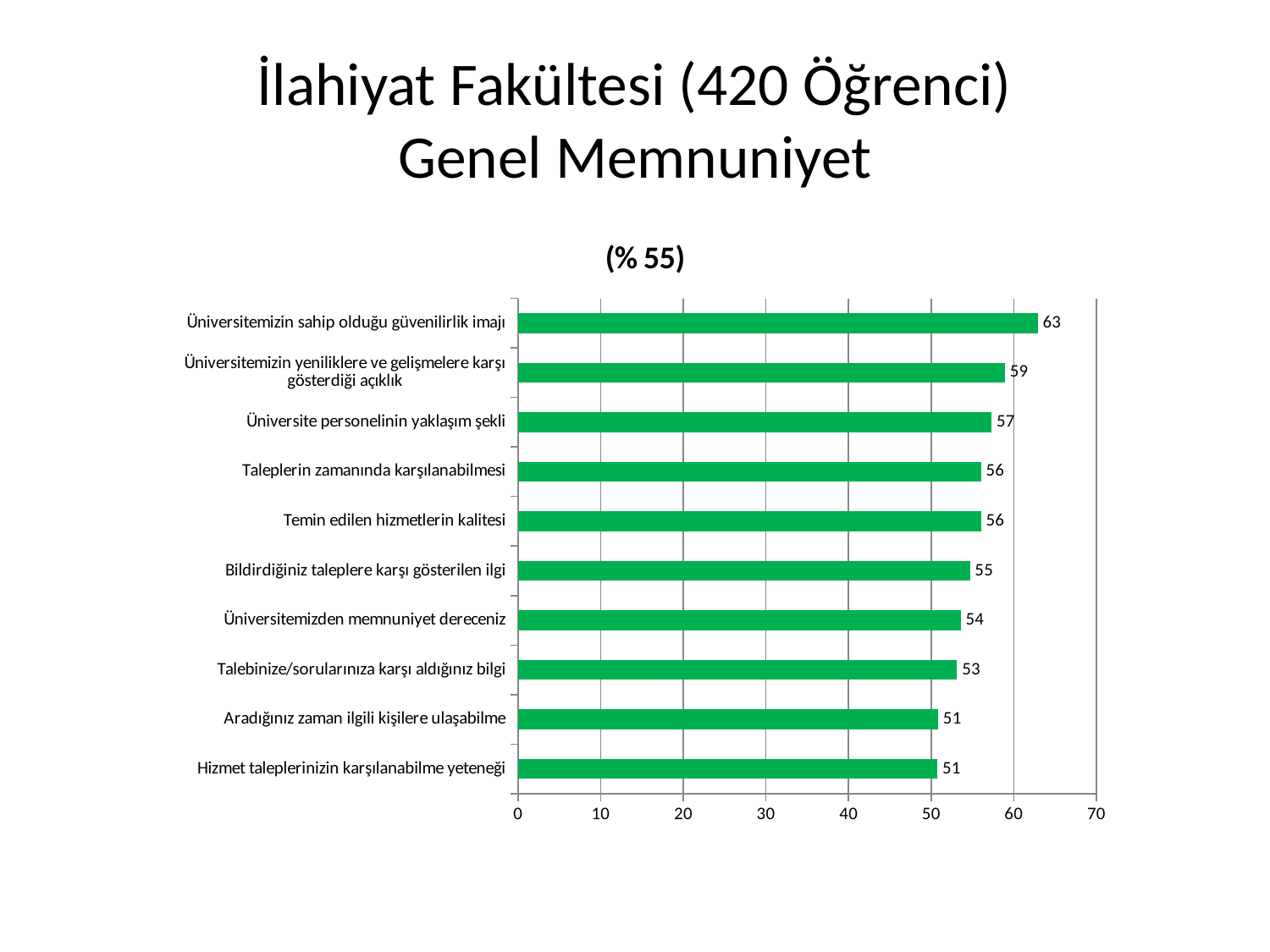
What is the lowest value shown in the chart? 51 What is the value for "Üniversite personelinin yaklaşım şekli"? 57 What is the value for "Talebinize/sorularınıza karşı aldığınız bilgi"? 53 What is the title shown above the chart? (% 55) Is the value for "Aradığınız zaman ilgili kişilere ulaşabilme" greater or less than 60? less Which category has the highest value? Üniversitemizin sahip olduğu güvenilirlik imajı How many categories are shown in the chart? 10 What kind of chart is shown on the slide? bar chart Which is larger: the value for "Üniversitemizin yeniliklere ve gelişmelere karşı gösterdiği açıklık" or the value for "Bildirdiğiniz taleplere karşı gösterilen ilgi"? Üniversitemizin yeniliklere ve gelişmelere karşı gösterdiği açıklık What is the value for "Üniversitemizin sahip olduğu güvenilirlik imajı"? 63 What is the value for "Üniversitemizden memnuniyet dereceniz"? 54 What is the difference between the values for "Üniversitemizin sahip olduğu güvenilirlik imajı" and "Hizmet taleplerinizin karşılanabilme yeteneği"? 12